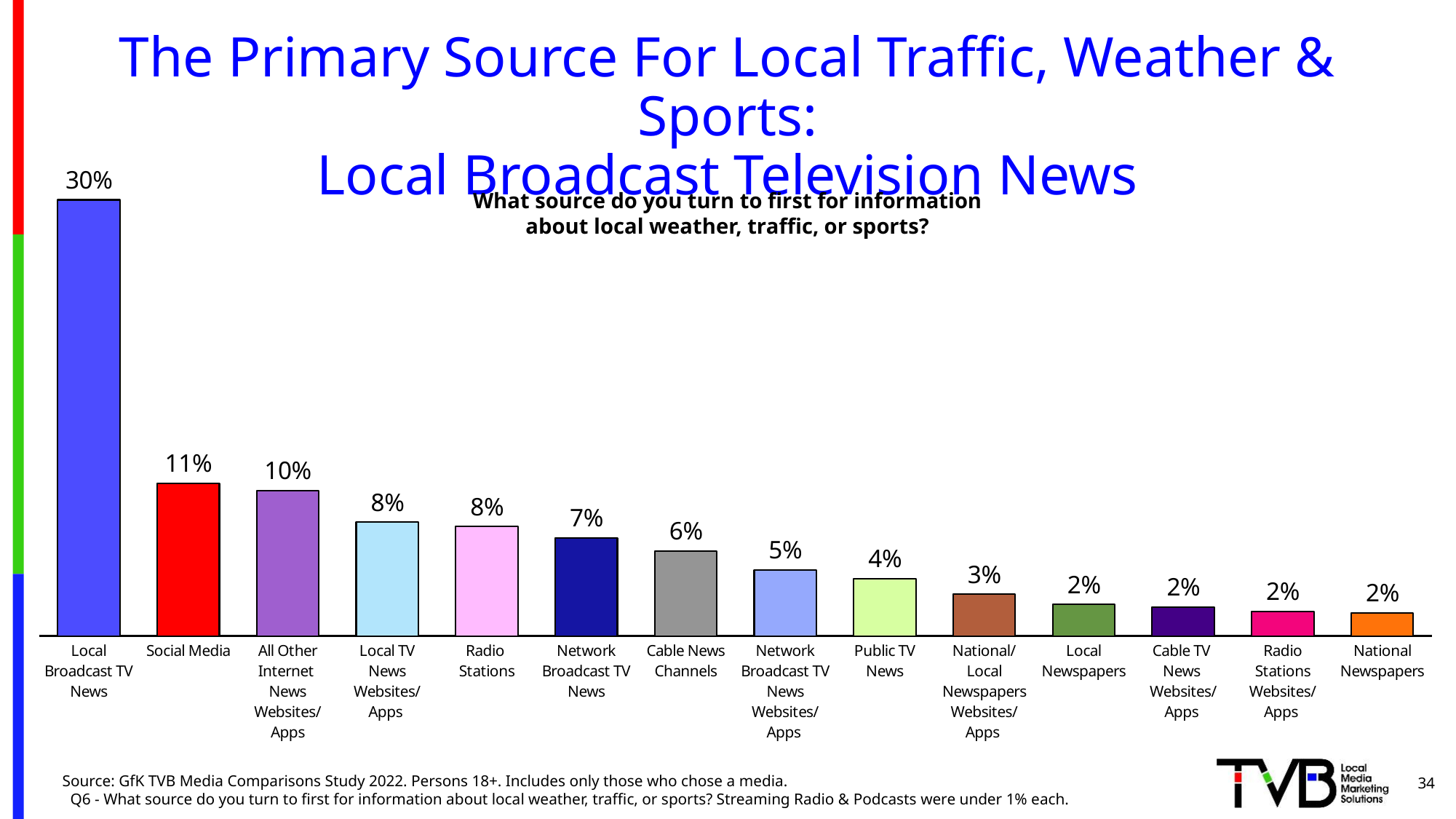
What is the difference between the values for Local Broadcast TV News and Social Media? 19 percentage points How many sources (categories) are shown in the chart? 14 Which source has the highest value in the chart? Local Broadcast TV News Which is larger, the value for Network Broadcast TV News Websites/Apps or the value for National/Local Newspapers Websites/Apps? Network Broadcast TV News Websites/Apps What is the value for Public TV News? 4% What is the value shown for Social Media? 11% Which is larger, the value for Radio Stations or the value for Cable News Channels? Radio Stations What value is shown for Cable News Channels? 6% Do the values generally rise or fall moving from left to right across the chart? Fall What is the difference between the values for All Other Internet News Websites/Apps and Network Broadcast TV News? 3 percentage points What percentage of respondents turn first to Local Broadcast TV News for local weather, traffic, or sports? 30% What kind of chart is shown on the slide? Bar chart